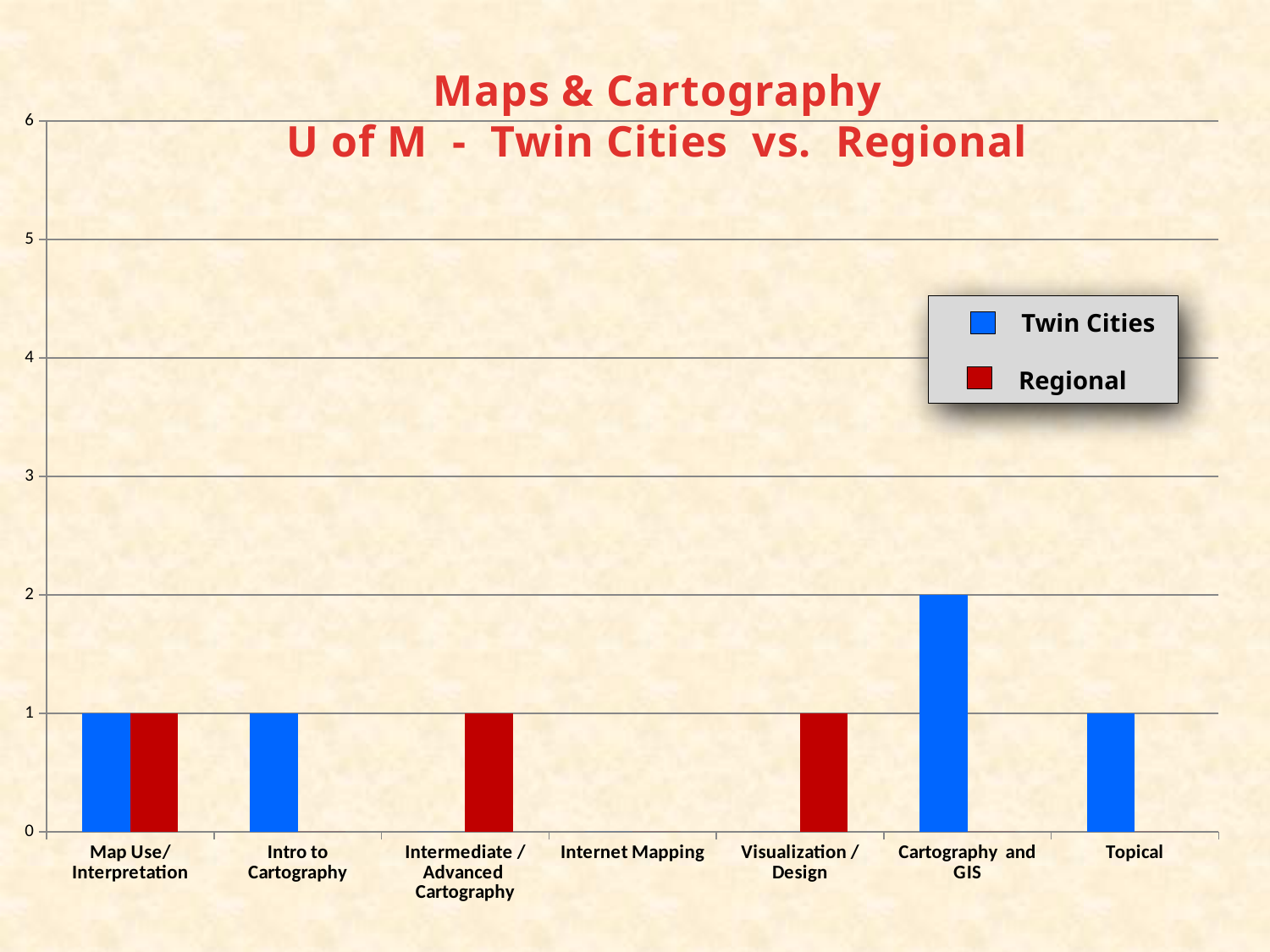
What is the title of the chart? Maps & Cartography U of M - Twin Cities vs. Regional How many series does the legend list? 2 Which colour represents the Regional series in the legend? Red What is the Twin Cities value for Cartography and GIS? 2 Which is larger: the Twin Cities value for Cartography and GIS or the Regional value for Map Use/Interpretation? Twin Cities value for Cartography and GIS What is the Regional value for Visualization / Design? 1 What is the difference between the Twin Cities value for Cartography and GIS and the Twin Cities value for Intro to Cartography? 1 Which category has the highest Twin Cities value? Cartography and GIS What is the Twin Cities value for Topical? 1 How many categories are shown on the x axis? 7 What kind of chart is shown on the slide? Bar chart Is the Twin Cities value for Cartography and GIS greater or less than 3? less